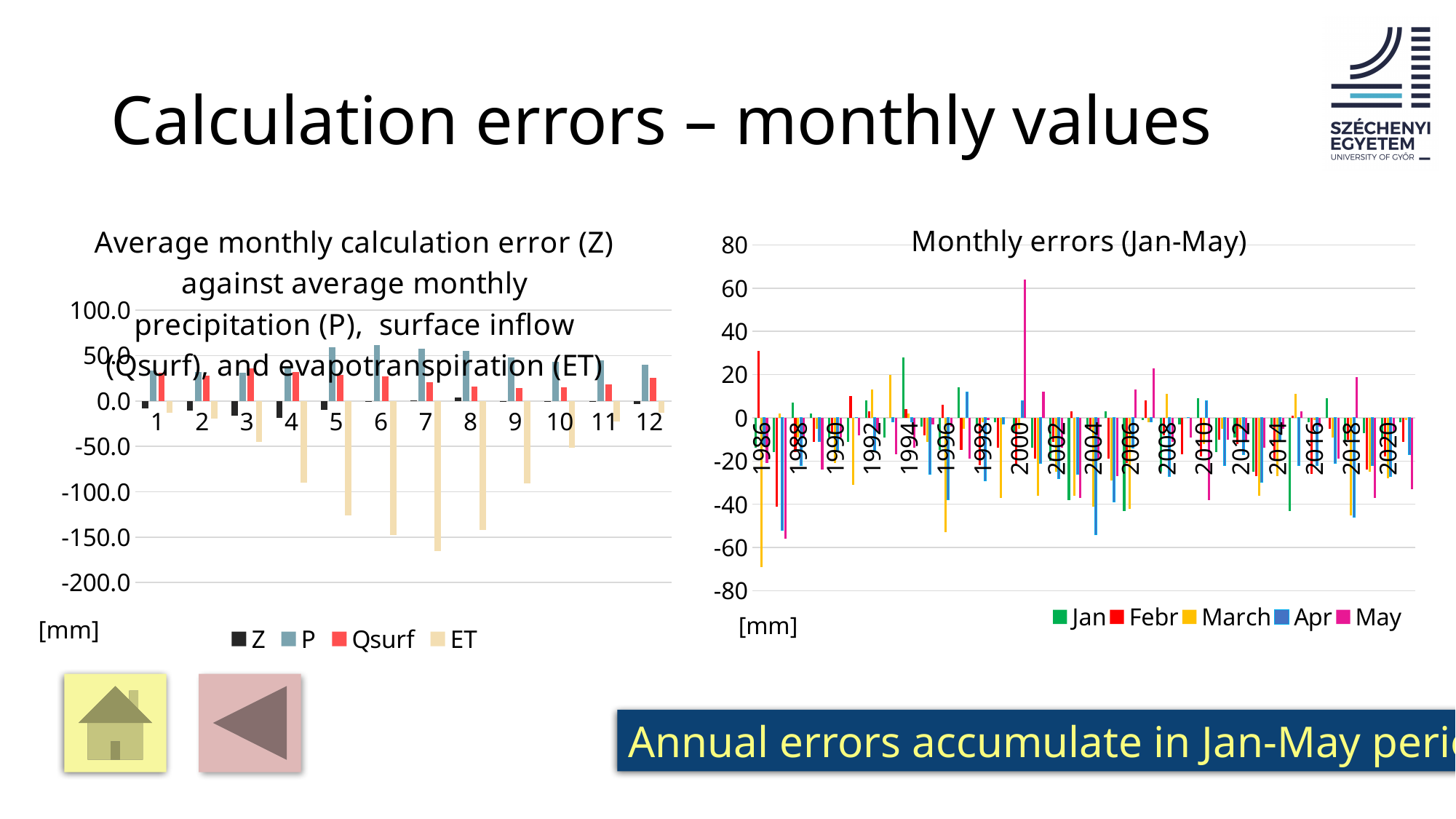
In the left chart (average monthly calculation error), is the ET value for month 7 greater or less than -150.0? less In the right chart 'Monthly errors (Jan-May)', is the May value for 2000 greater or less than 40? greater In the left chart (average monthly calculation error), how many months are shown on the x axis? 12 What kind of chart is the right chart, 'Monthly errors (Jan-May)'? bar chart In the right chart 'Monthly errors (Jan-May)', what are the legend entries? Jan, Febr, March, Apr, May What kind of chart is the left chart, 'Average monthly calculation error (Z) against average monthly precipitation (P), surface inflow (Qsurf), and evapotranspiration (ET)'? bar chart In the left chart (average monthly calculation error), which month has the lowest ET value? 7 In the left chart (average monthly calculation error), is the P value for month 6 greater or less than 50.0? greater In the right chart 'Monthly errors (Jan-May)', how many series does the legend list? 5 In the left chart (average monthly calculation error), how many series does the legend list? 4 In the left chart (average monthly calculation error), which is lower, the ET value for month 7 or the ET value for month 1? month 7